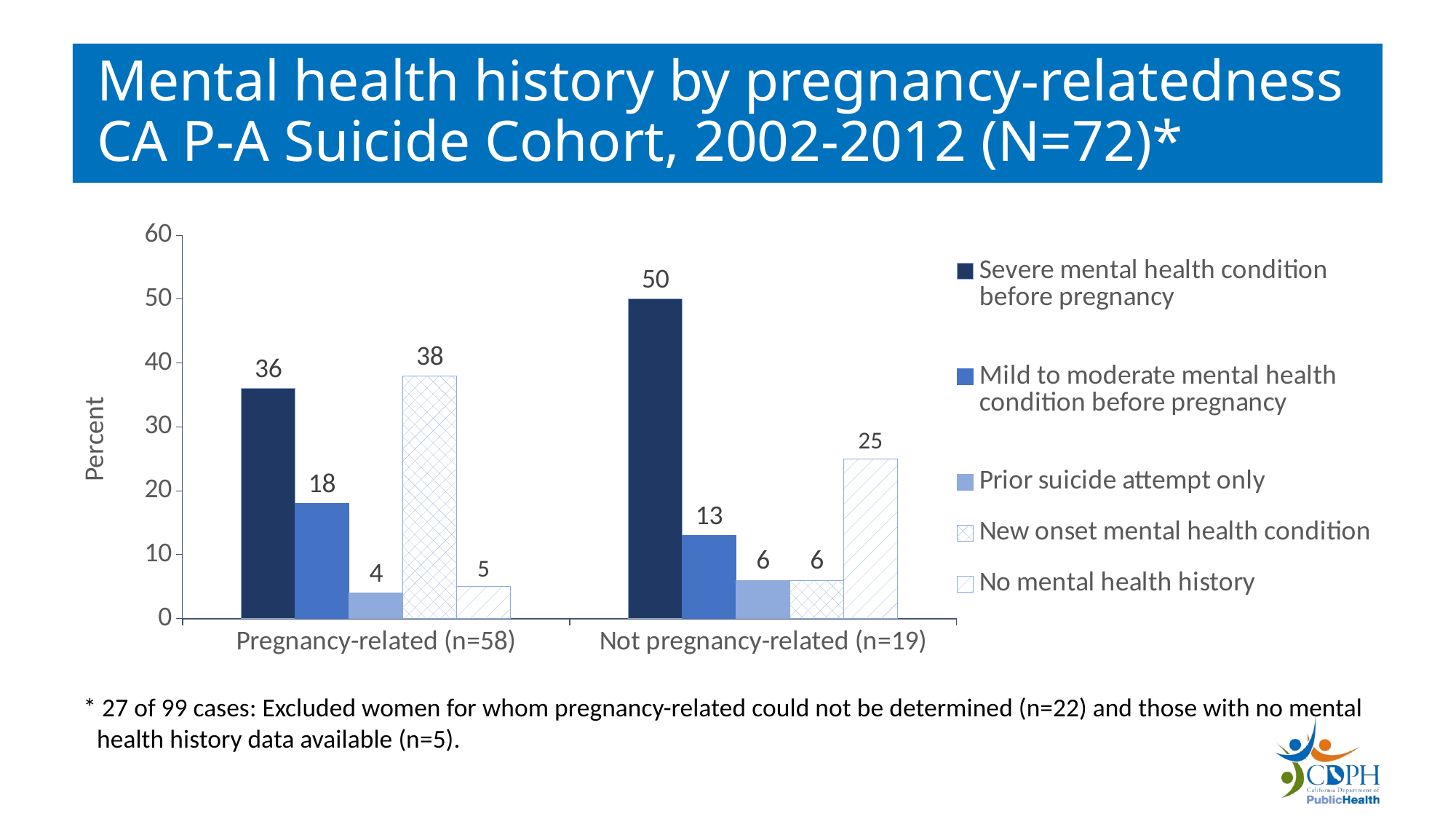
What is the value for 'No mental health history' in the Pregnancy-related (n=58) group? 5 Which group has the larger value for 'New onset mental health condition', Pregnancy-related or Not pregnancy-related? Pregnancy-related (n=58) What kind of chart is shown on the slide? Bar chart What is the value for 'Severe mental health condition before pregnancy' in the Pregnancy-related (n=58) group? 36 What is the difference between the 'Severe mental health condition before pregnancy' values for the Not pregnancy-related and Pregnancy-related groups? 14 How many categories are shown on the x axis? 2 What is the value for 'New onset mental health condition' in the Not pregnancy-related (n=19) group? 6 What is the label of the y axis? Percent Which series has the highest value in the Not pregnancy-related (n=19) group? Severe mental health condition before pregnancy Is the value for 'Mild to moderate mental health condition before pregnancy' in the Pregnancy-related group greater or less than 20? less Which series has the lowest value in the Pregnancy-related (n=58) group? Prior suicide attempt only How many series does the legend list? 5